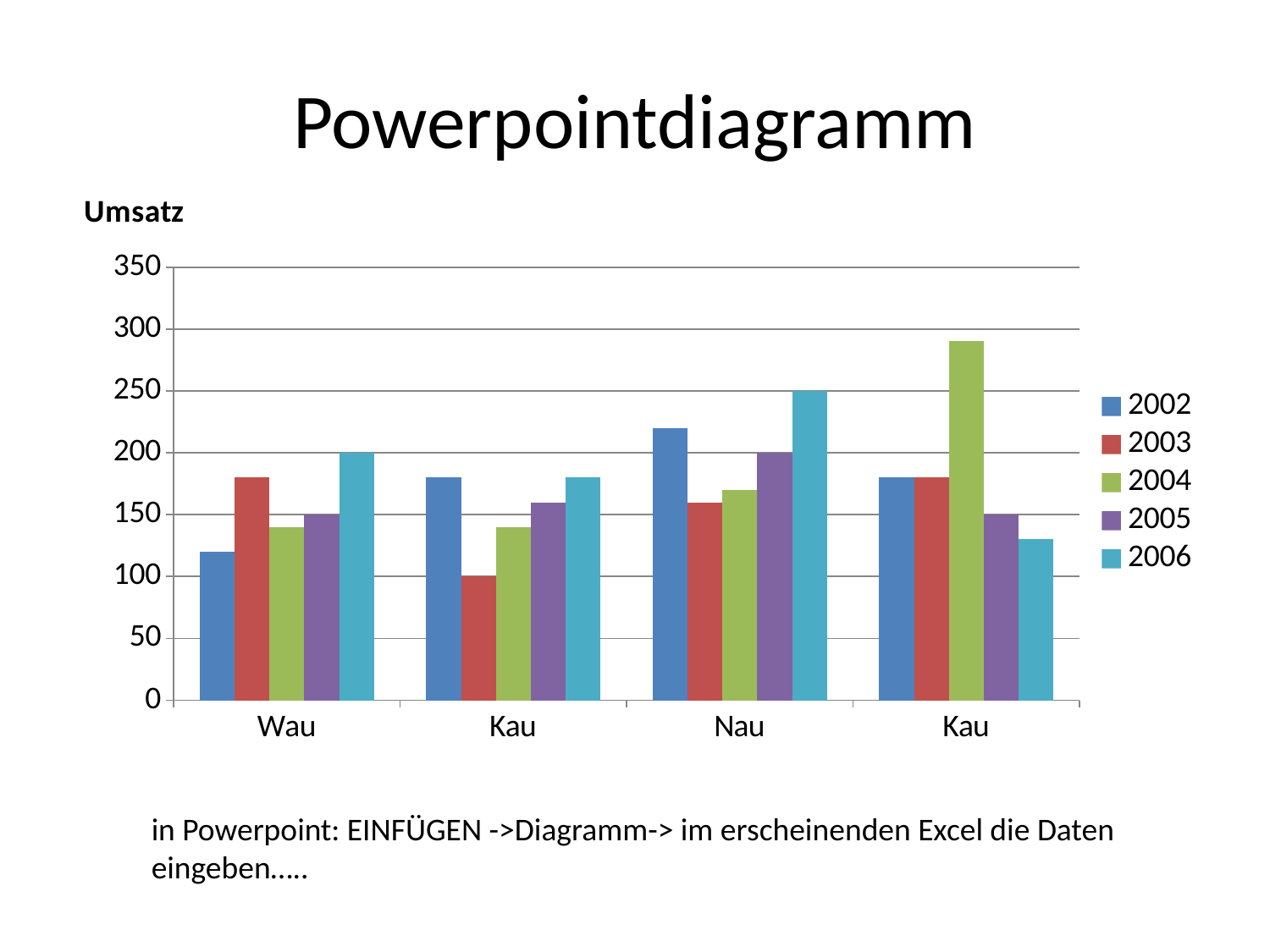
Which series has the lowest bar in the Wau category? 2002 What kind of chart is shown on the slide? bar chart How many series does the legend list? 5 Which series has the highest bar in the Wau category? 2006 What is the difference between the 2006 value and the 2005 value in the Nau category? 50 What is the value for 2006 in the Nau category? 250 What is the value for 2006 in the Wau category? 200 How many categories are shown on the x axis? 4 What is the title of the chart? Umsatz Is the value for 2002 in the Nau category greater or less than 200? greater Which is larger in the Wau category, the value for 2003 or the value for 2004? 2003 What is the value for 2003 in the first Kau category (second from the left)? 100